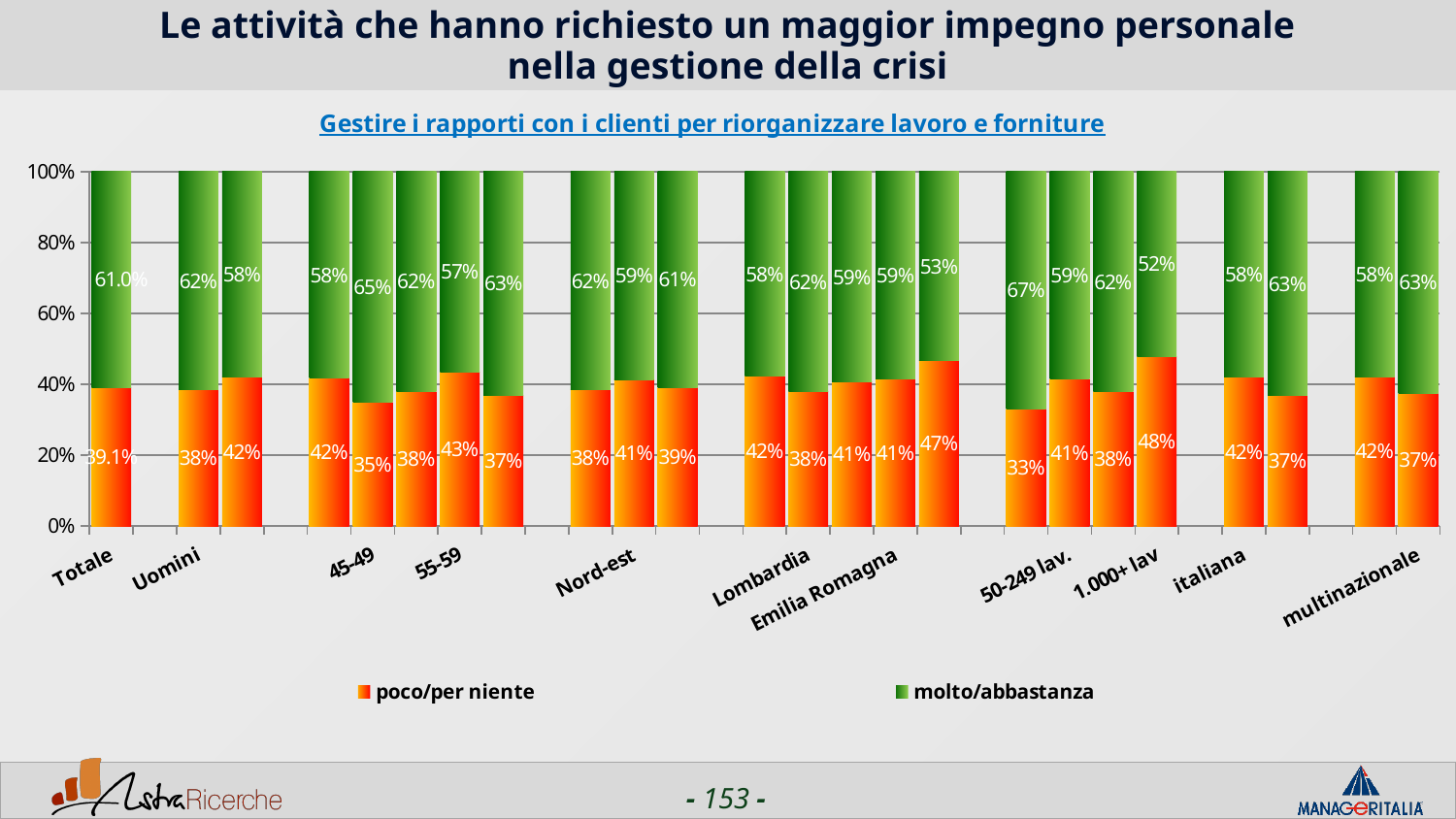
What is the difference between the 'molto/abbastanza' and 'poco/per niente' values for Totale? 21.9 percentage points What is the 'poco/per niente' value for the 1.000+ lav category? 48% What is the 'molto/abbastanza' value for multinazionale? 63% Which colour represents 'poco/per niente' in the legend? orange What is the 'molto/abbastanza' value for the 45-49 category? 65% What is the 'poco/per niente' value for Totale? 39.1% How many series does the legend list? 2 Which has the larger 'molto/abbastanza' value, Uomini or Totale? Uomini What kind of chart is shown on the slide? bar chart What is the subtitle shown above the chart? Gestire i rapporti con i clienti per riorganizzare lavoro e forniture What is the 'molto/abbastanza' value for Totale? 61.0% What is the 'molto/abbastanza' value for Uomini? 62%